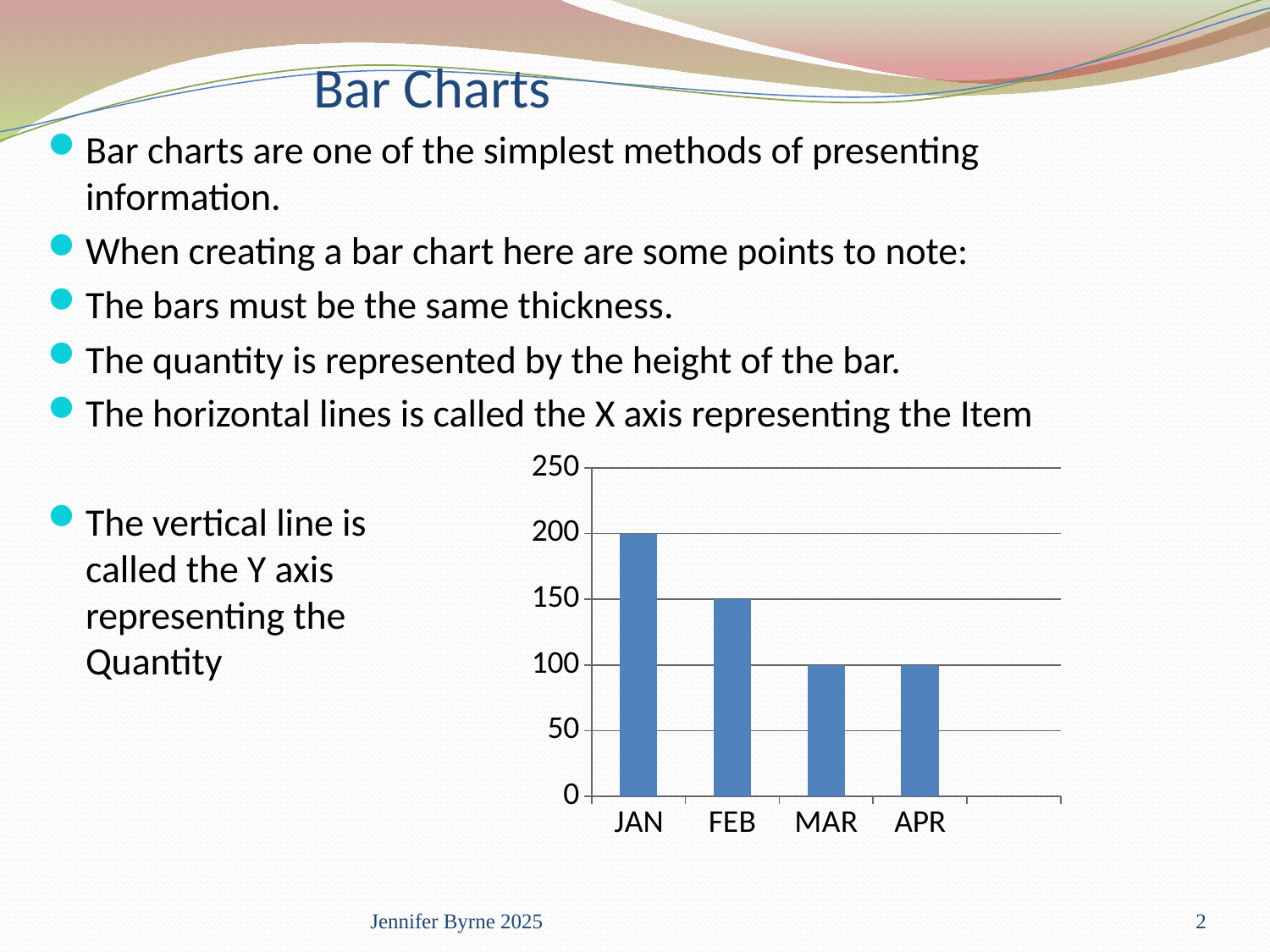
Do the values generally rise or fall from JAN to APR? fall Which month has the highest bar in the chart? JAN What kind of chart is shown on the slide? bar chart What is the difference between the values for FEB and MAR? 50 What is the value for JAN in the chart? 200 What is the difference between the values for JAN and FEB? 50 What is the value for FEB in the chart? 150 Which is larger, the value for JAN or the value for MAR? JAN How many categories are shown on the x axis of the chart? 4 Is the value for FEB greater or less than 100? greater What is the value for MAR in the chart? 100 What is the value for APR in the chart? 100